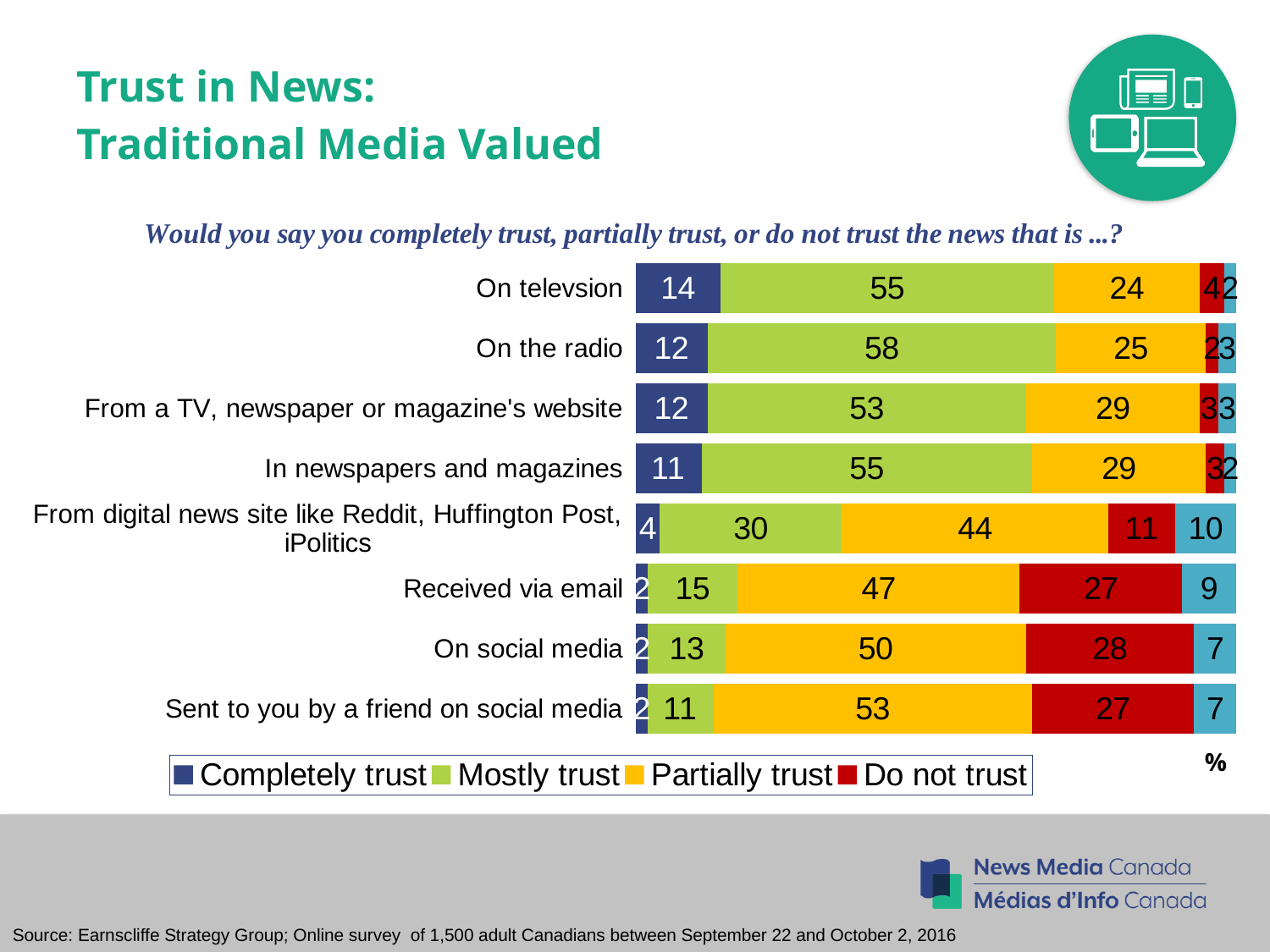
What is the 'Partially trust' value for news from a digital news site like Reddit, Huffington Post, iPolitics? 44 What is the 'Mostly trust' value for news on the radio? 58 What is the 'Completely trust' value for news on television? 14 How many news sources (categories) are shown in the chart? 8 How many series does the chart's legend list? 4 What is the difference between the 'Partially trust' values for news on social media and news on the radio? 25 What kind of chart is shown on the slide? Stacked bar chart Which news source has the highest 'Do not trust' value? On social media Which news source has the highest 'Completely trust' value? On televsion Which is larger: the 'Mostly trust' value for news in newspapers and magazines or for news from a TV, newspaper or magazine's website? In newspapers and magazines Which news source has the highest 'Mostly trust' value? On the radio What is the 'Do not trust' value for news received via email? 27